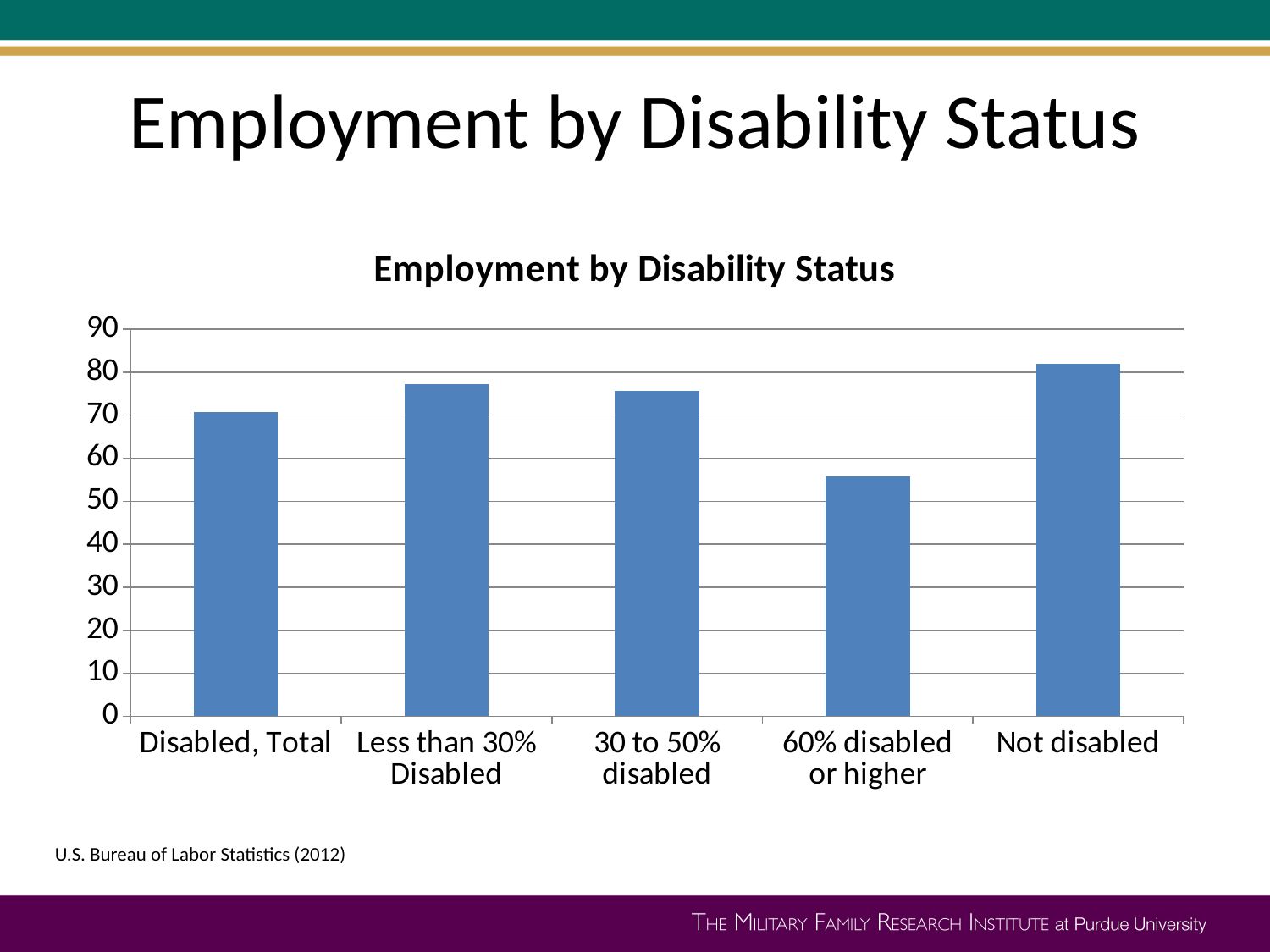
Which is larger, the value for 60% disabled or higher or the value for Disabled, Total? Disabled, Total Is the value for 30 to 50% disabled greater or less than 70? greater Which category has the highest value in the chart? Not disabled Is the value for 60% disabled or higher greater or less than 60? less Is the value for Less than 30% Disabled greater or less than 80? less What kind of chart is shown on the slide? bar chart Which category has the lowest value in the chart? 60% disabled or higher What is the title of the chart? Employment by Disability Status Which is larger, the value for Not disabled or the value for Disabled, Total? Not disabled How many categories are shown on the x axis of the chart? 5